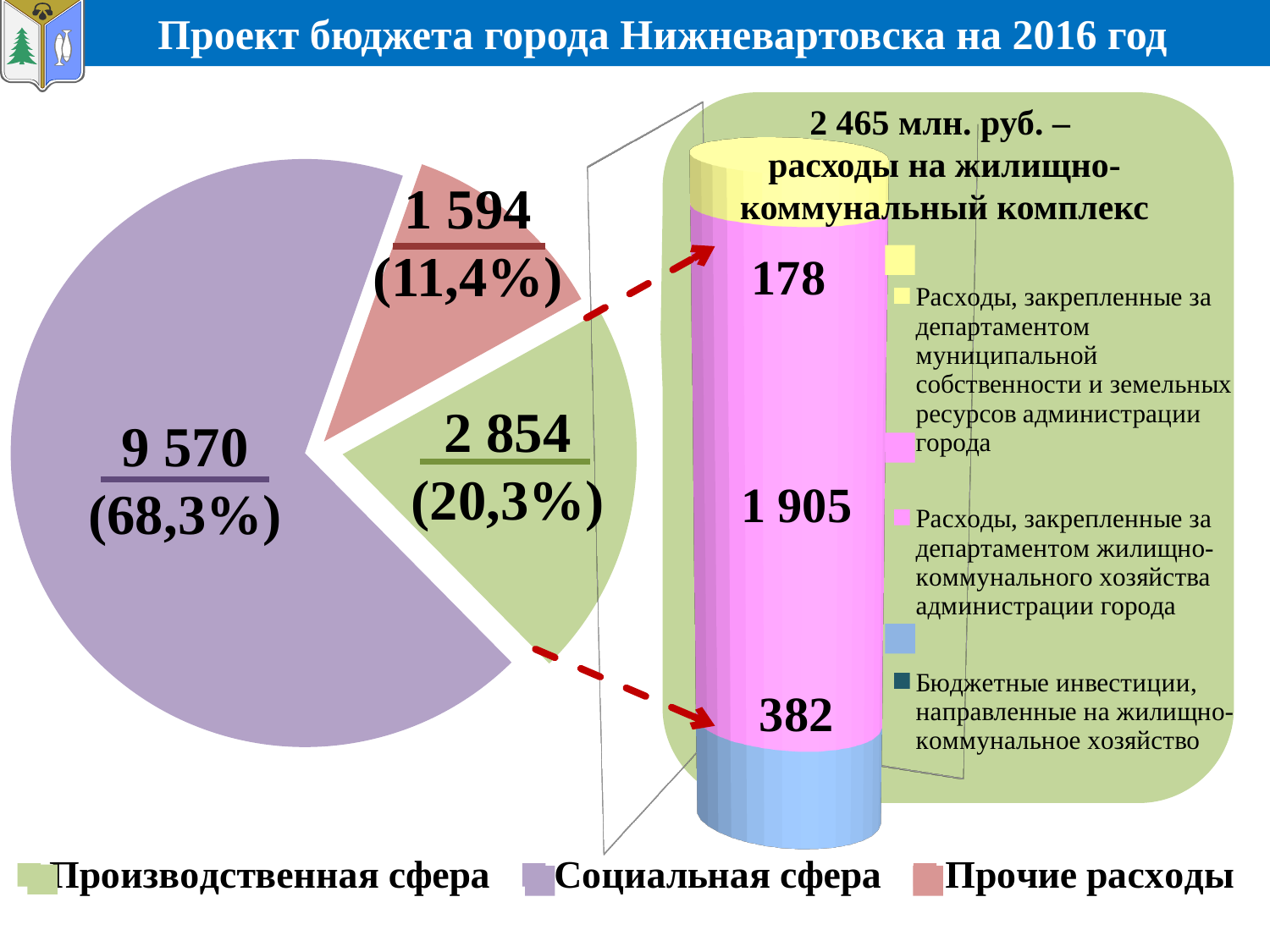
On the stacked bar chart on the right, which segment is the smallest? Расходы, закрепленные за департаментом муниципальной собственности и земельных ресурсов администрации города On the pie chart, what value is shown for Социальная сфера? 9 570 On the stacked bar chart on the right, what value is shown for Бюджетные инвестиции, направленные на жилищно-коммунальное хозяйство? 382 On the stacked bar chart on the right, what value is shown for Расходы, закрепленные за департаментом жилищно-коммунального хозяйства администрации города? 1 905 How many categories does the pie chart legend list? 3 On the pie chart, what percentage share does Производственная сфера have? 20,3% On the pie chart, which category has the smallest slice? Прочие расходы On the pie chart, what value is shown for Прочие расходы? 1 594 What is the total of the stacked bar on the right (178 + 1 905 + 382)? 2 465 What type of chart is shown on the left of the slide? Pie chart On the pie chart, what is the difference between the values for Производственная сфера and Прочие расходы? 1 260 On the pie chart, which category has the largest slice? Социальная сфера